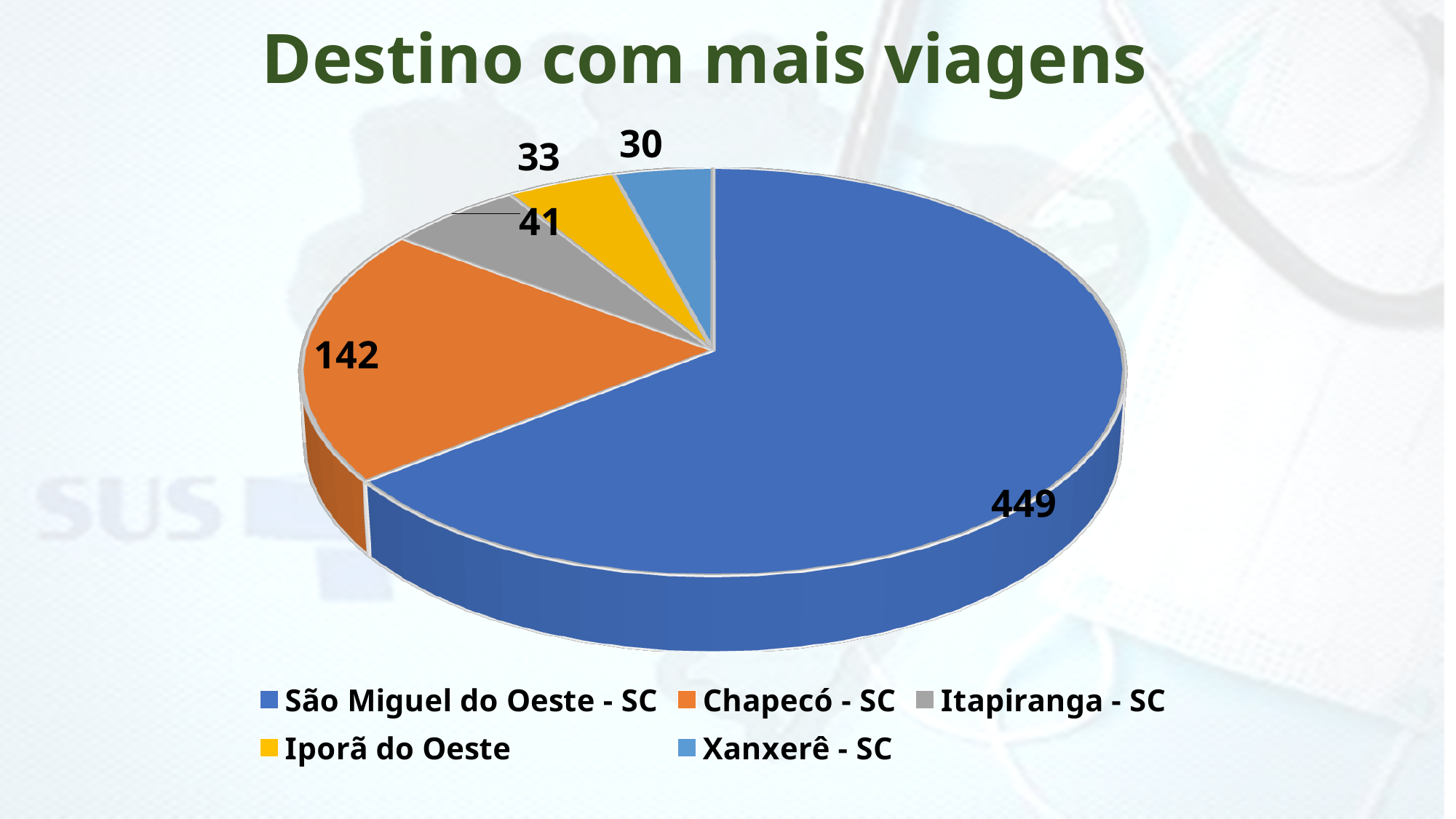
What kind of chart is shown on the slide? Pie chart What is the value for Xanxerê - SC? 30 Which destination has the lowest value? Xanxerê - SC What is the value for São Miguel do Oeste - SC? 449 What is the value for Itapiranga - SC? 41 What is the value for Chapecó - SC? 142 What is the title of the chart? Destino com mais viagens How many destinations (slices) does the pie chart show? 5 What is the difference between the values for São Miguel do Oeste - SC and Chapecó - SC? 307 What is the total of all the values shown in the pie chart? 695 Which is larger, the value for Itapiranga - SC or the value for Iporã do Oeste? Itapiranga - SC Which destination has the highest value? São Miguel do Oeste - SC